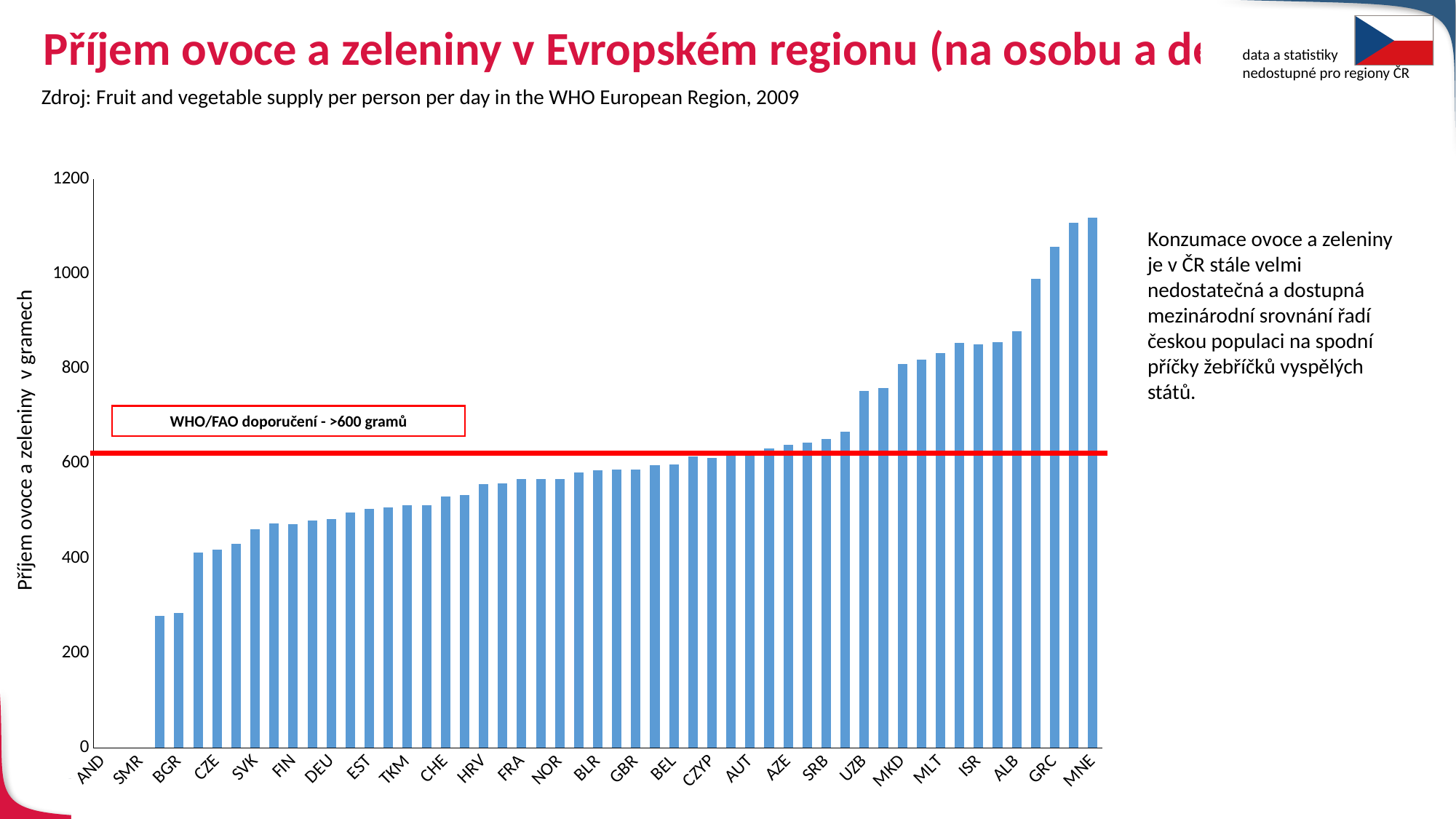
Is the value for BGR greater or less than 400? less Is the value for GRC greater or less than 1000? greater Is the value for ALB greater or less than 800? greater Which labelled country has the highest fruit and vegetable supply in the chart? MNE Which has a larger value, GRC or DEU? GRC Do the bar values rise or fall from left to right along the x axis? rise Which has a larger value, MNE or CZE? MNE What kind of chart is shown on the slide? bar chart What does the red horizontal line in the chart represent, according to its label? WHO/FAO doporučení - >600 gramů